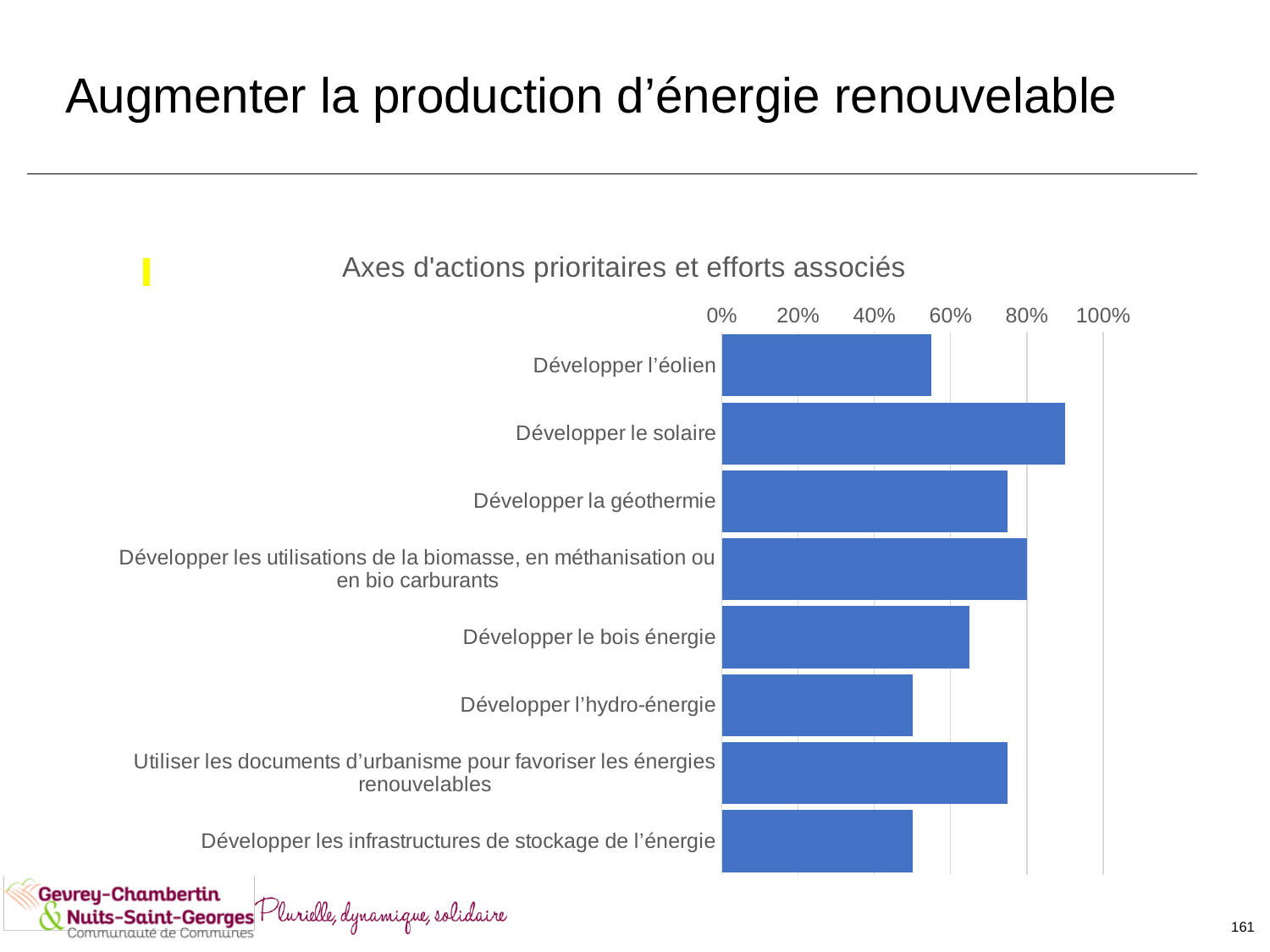
What kind of chart is shown on the slide? bar chart Is the value for "Développer la géothermie" greater or less than 60%? greater How many categories (action axes) are plotted in the chart? 8 Is the value for "Développer le solaire" greater or less than 80%? greater What is the title of the chart? Axes d'actions prioritaires et efforts associés Is the value for "Développer les infrastructures de stockage de l'énergie" greater or less than 40%? greater Which has a larger value: "Développer la géothermie" or "Développer le bois énergie"? Développer la géothermie Which category has the highest value in the chart? Développer le solaire Which has a larger value: "Développer le solaire" or "Développer l'éolien"? Développer le solaire